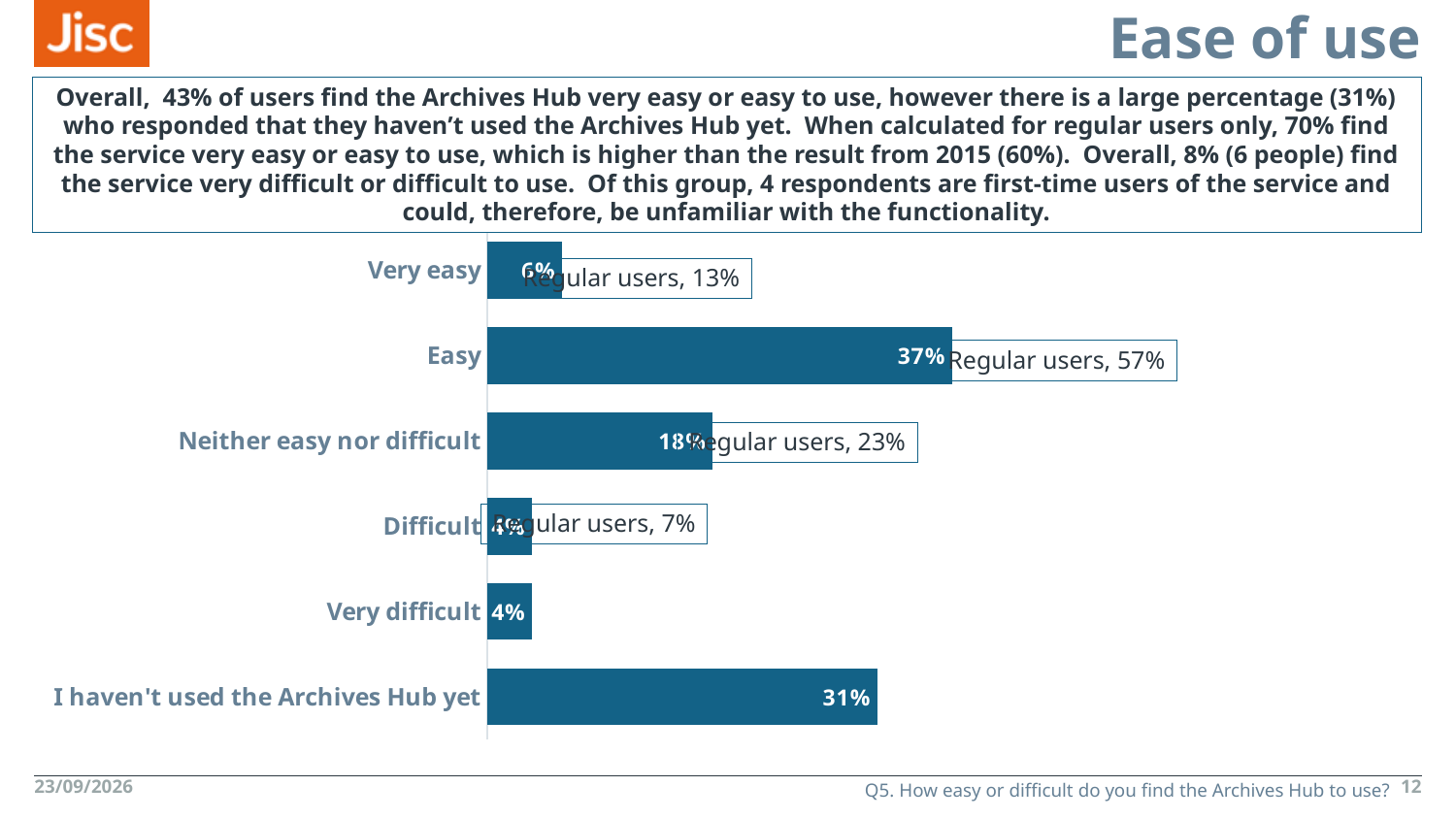
What percentage of users responded 'I haven't used the Archives Hub yet'? 31% What percentage of users responded 'Easy'? 37% What percentage of regular users responded 'Easy', according to the annotation on the chart? 57% What percentage of users responded 'Very difficult'? 4% Which response category has the highest percentage? Easy What is the title of the slide? Ease of use What is the difference between the 'Easy' and 'Neither easy nor difficult' percentages? 19% What kind of chart is shown on the slide? bar chart What percentage of users responded 'Neither easy nor difficult'? 18% How many response categories are shown in the chart? 6 Which is larger, the percentage for 'Easy' or for 'I haven't used the Archives Hub yet'? Easy What percentage of users responded 'Very easy'? 6%